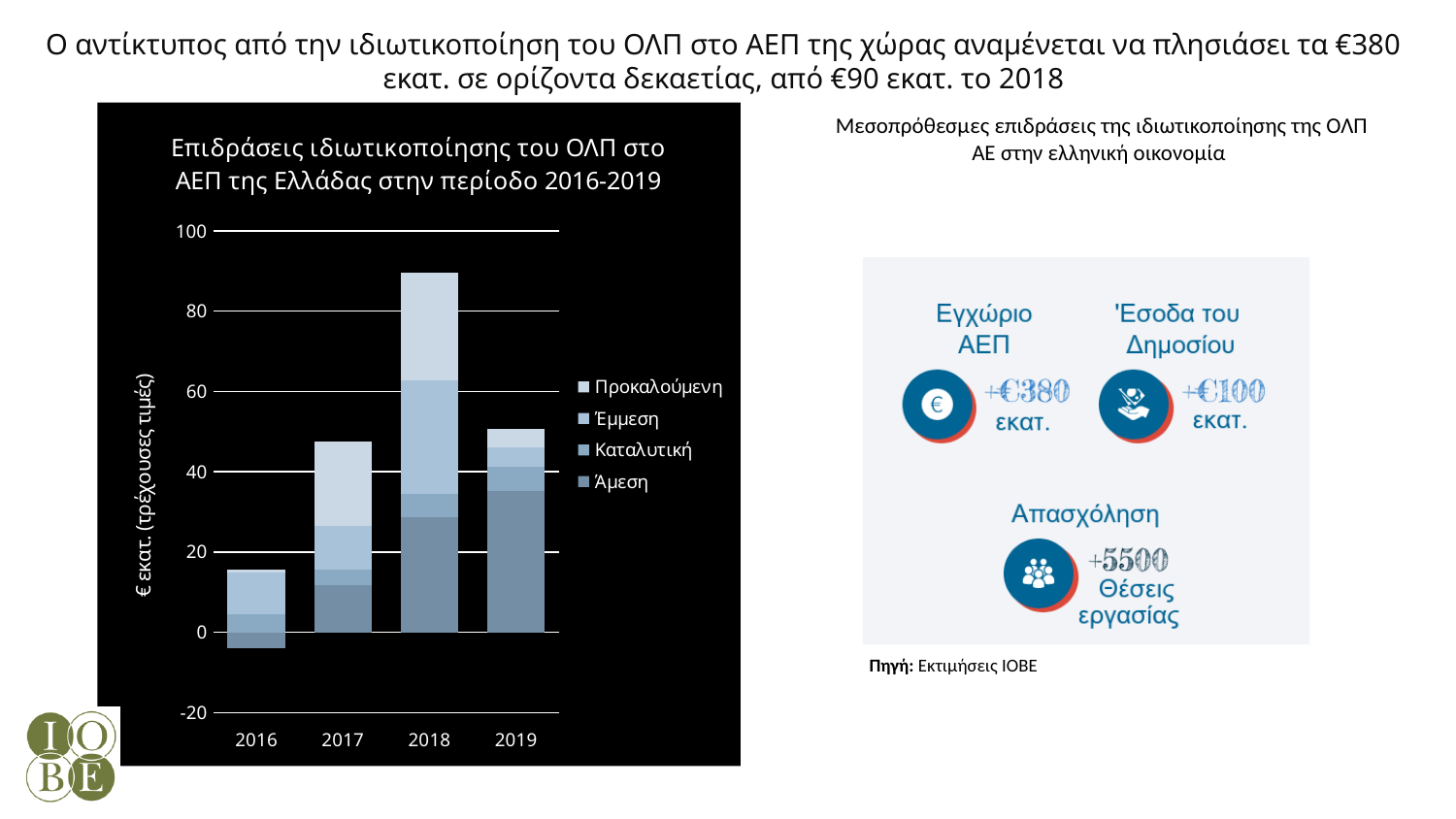
What is the label of the chart's y axis? € εκατ. (τρέχουσες τιμές) What is the title of the chart? Επιδράσεις ιδιωτικοποίησης του ΟΛΠ στο ΑΕΠ της Ελλάδας στην περίοδο 2016-2019 Which year has the larger total stacked bar, 2018 or 2019? 2018 Which year has the highest total stacked bar in the chart? 2018 Which year has the lowest total stacked bar in the chart? 2016 How many series does the chart's legend list? 4 Is the total stacked value for 2016 greater or less than 20? less What kind of chart is shown on the slide? Stacked bar chart Is the Άμεση value for 2016 greater or less than 0? less Is the total stacked value for 2017 greater or less than 40? greater How many years (categories) are shown on the x axis of the chart? 4